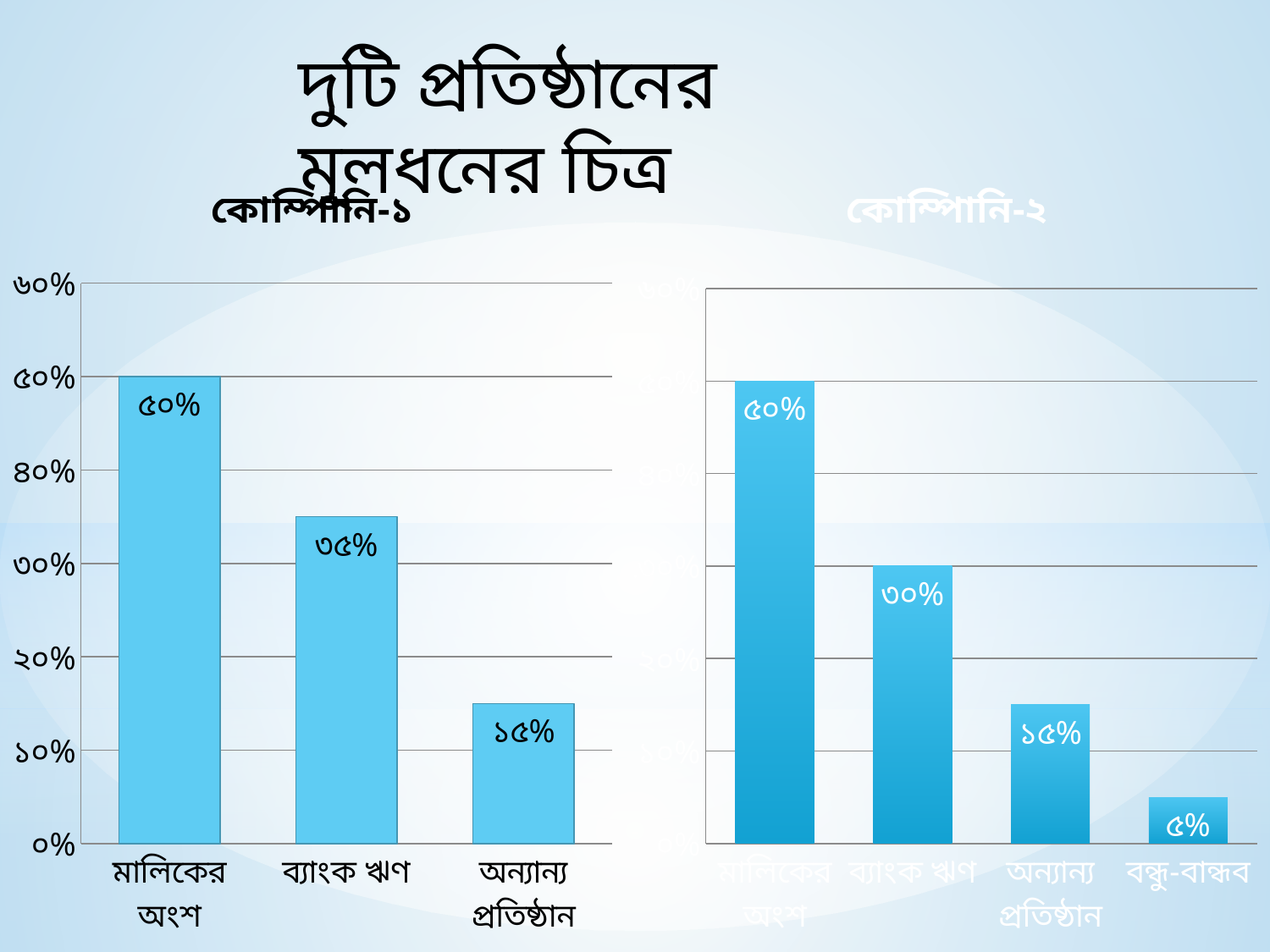
In the কোম্পানি-২ chart, which category has the highest value? মালিকের অংশ In the কোম্পানি-২ chart, what is the difference between the values for ব্যাংক ঋণ and অন্যান্য প্রতিষ্ঠান? ১৫% How many categories are shown in the কোম্পানি-২ chart? 4 What kind of chart is the কোম্পানি-১ chart? Bar chart In the কোম্পানি-১ chart, what is the difference between the values for মালিকের অংশ and ব্যাংক ঋণ? ১৫% In the কোম্পানি-১ chart, what is the value for ব্যাংক ঋণ? ৩৫% In the কোম্পানি-১ chart, what is the value for মালিকের অংশ? ৫০% How many categories are shown in the কোম্পানি-১ chart? 3 In the কোম্পানি-২ chart, what is the value for ব্যাংক ঋণ? ৩০% In the কোম্পানি-১ chart, which category has the lowest value? অন্যান্য প্রতিষ্ঠান Which is larger: ব্যাংক ঋণ in the কোম্পানি-১ chart or ব্যাংক ঋণ in the কোম্পানি-২ chart? কোম্পানি-১ In the কোম্পানি-২ chart, what is the value for বন্ধু-বান্ধব? ৫%